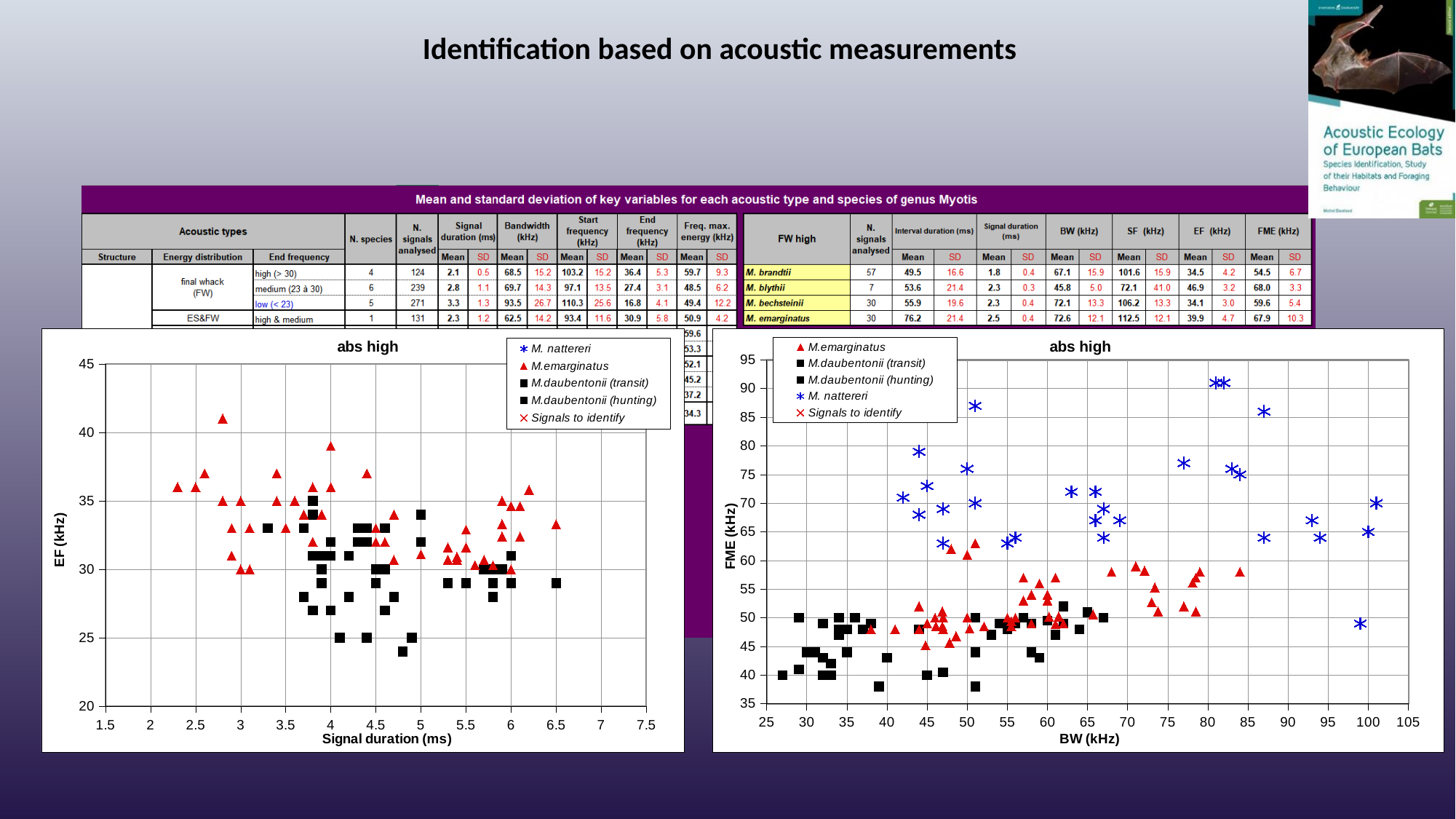
What kind of chart is the right chart titled 'abs high'? scatter chart On the right chart, is the highest M. nattereri point greater or less than 85 on the FME (kHz) axis? greater On the right chart, how many series does the legend list? 5 On the left chart, what is the label of the x axis? Signal duration (ms) On the right chart, is the lowest M. nattereri point greater or less than 60 on the FME (kHz) axis? less On the left chart, how many series does the legend list? 5 On the right chart, is the highest M.daubentonii point greater or less than 55 on the FME (kHz) axis? less On the right chart, what is the label of the y axis? FME (kHz) What kind of chart is the left chart titled 'abs high'? scatter chart On the right chart, which series generally has higher FME (kHz) values: M. nattereri or M.daubentonii (hunting)? M. nattereri